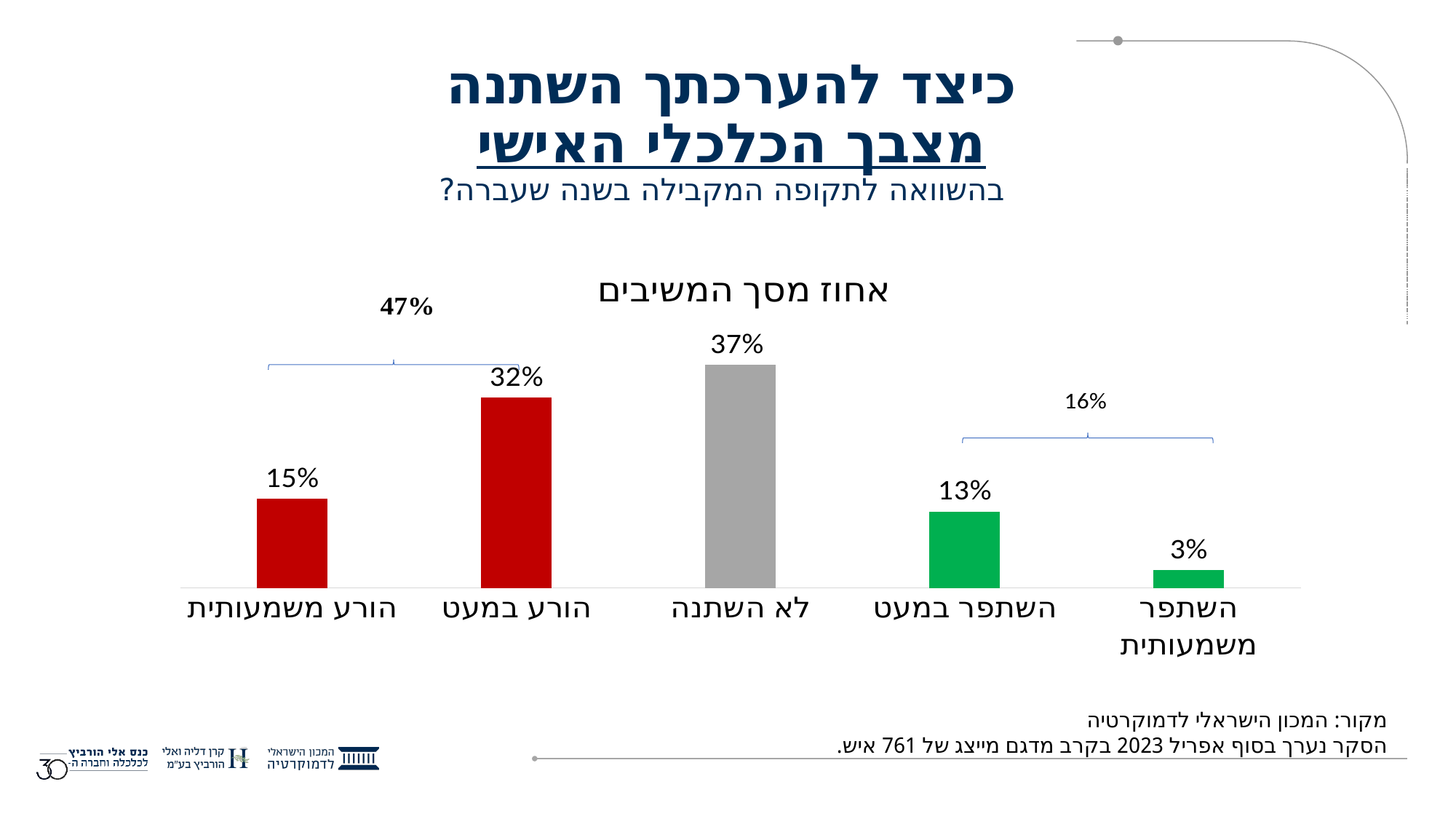
What is the title of the chart? אחוז מסך המשיבים What is the difference between the values for "הורע במעט" and "השתפר במעט"? 19% Which is larger, the value for "הורע משמעותית" or the value for "השתפר במעט"? הורע משמעותית How many categories are shown in the chart? 5 What is the value shown for "הורע במעט"? 32% What percentage of respondents answered "לא השתנה"? 37% Which category has the lowest value? השתפר משמעותית What combined percentage is shown by the bracket above the two "הורע" bars? 47% What is the value shown for "השתפר משמעותית"? 3% What kind of chart is shown on the slide? Bar chart Which category has the highest value? לא השתנה What combined percentage is shown by the bracket above the two "השתפר" bars? 16%